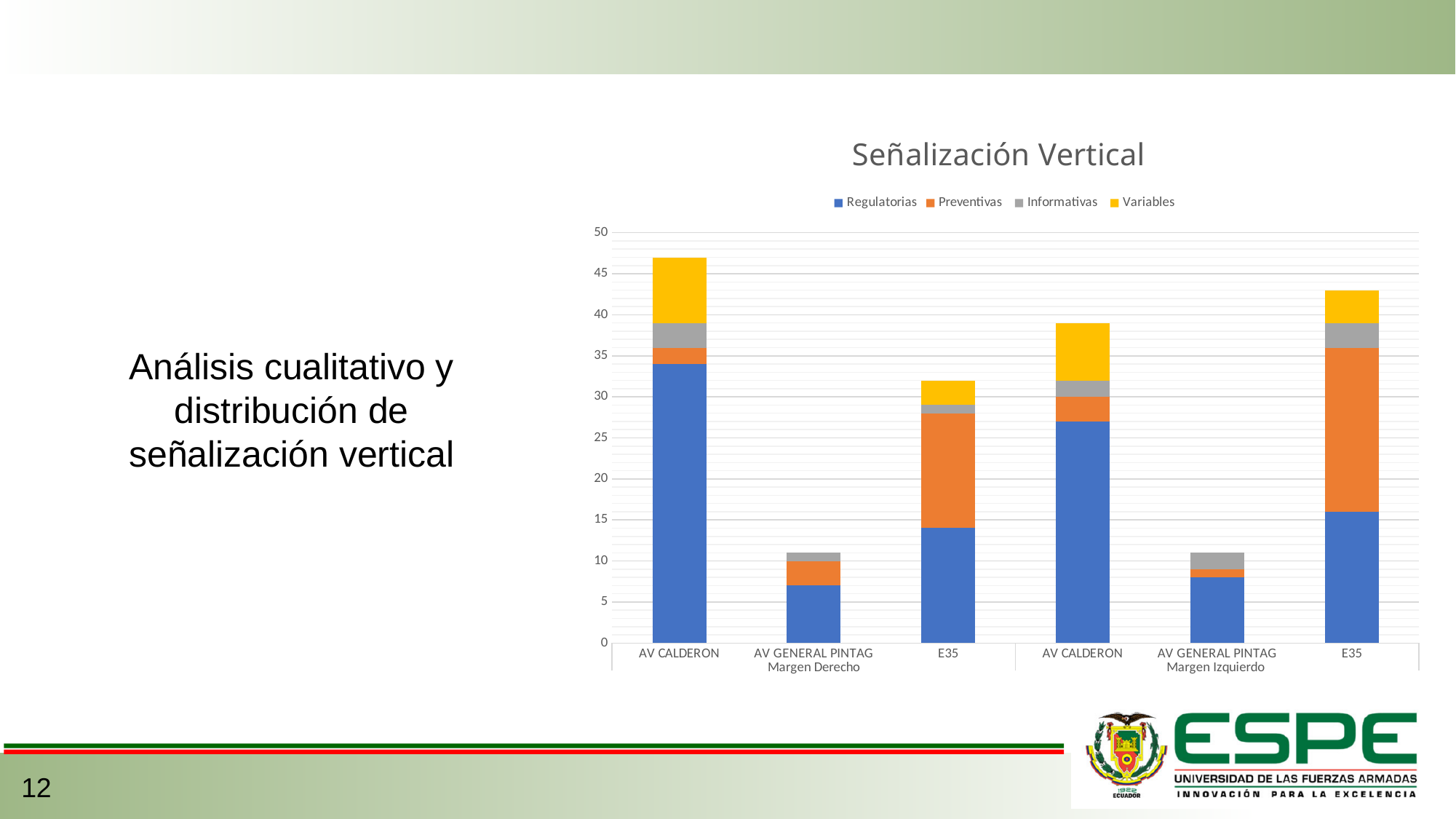
Is the total for AV GENERAL PINTAG in Margen Derecho greater or less than 15? less What kind of chart is shown on the slide? Stacked bar chart Which bar has the highest total? AV CALDERON (Margen Derecho) Which has the larger total: E35 in Margen Izquierdo or AV CALDERON in Margen Izquierdo? E35 (Margen Izquierdo) Is the Regulatorias value for E35 in Margen Izquierdo greater or less than 20? less How many bars are plotted in the chart? 6 Which colour represents the Variables series in the legend? Yellow Is the total for E35 in Margen Izquierdo greater or less than 40? greater What is the title of the chart? Señalización Vertical How many series does the legend list? 4